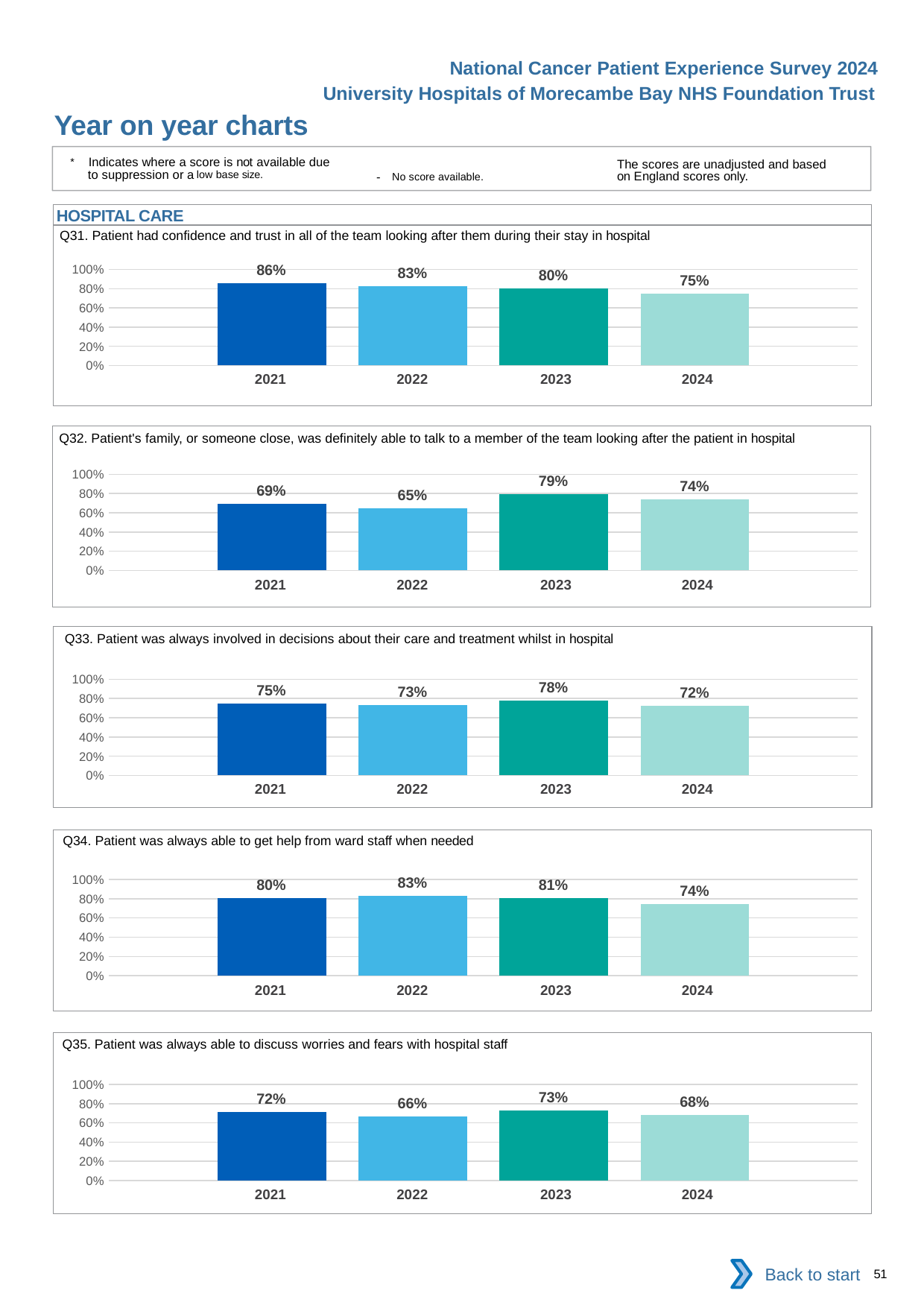
In the Q31 chart (patient had confidence and trust in all of the team), do the values rise or fall from 2021 to 2024? fall In the Q31 chart (patient had confidence and trust in all of the team), which year has the lowest value? 2024 In the Q33 chart (patient was always involved in decisions about their care), which is larger, the 2021 value or the 2023 value? 2023 How many years are shown on the x axis of the Q35 chart (patient was always able to discuss worries and fears)? 4 In the Q34 chart (patient was always able to get help from ward staff), what is the value for 2022? 83% In the Q34 chart (patient was always able to get help from ward staff), what is the difference between the 2022 and 2024 values? 9 percentage points In the Q32 chart (patient's family was definitely able to talk to a member of the team), which year has the highest value? 2023 What type of chart is the Q31 chart (patient had confidence and trust in all of the team)? bar chart In the Q31 chart (patient had confidence and trust in all of the team), what is the value for 2021? 86% In the Q32 chart (patient's family was definitely able to talk to a member of the team), what is the difference between the 2023 and 2022 values? 14 percentage points In the Q33 chart (patient was always involved in decisions about their care), what is the value for 2024? 72% In the Q35 chart (patient was always able to discuss worries and fears), which year has the lowest value? 2022